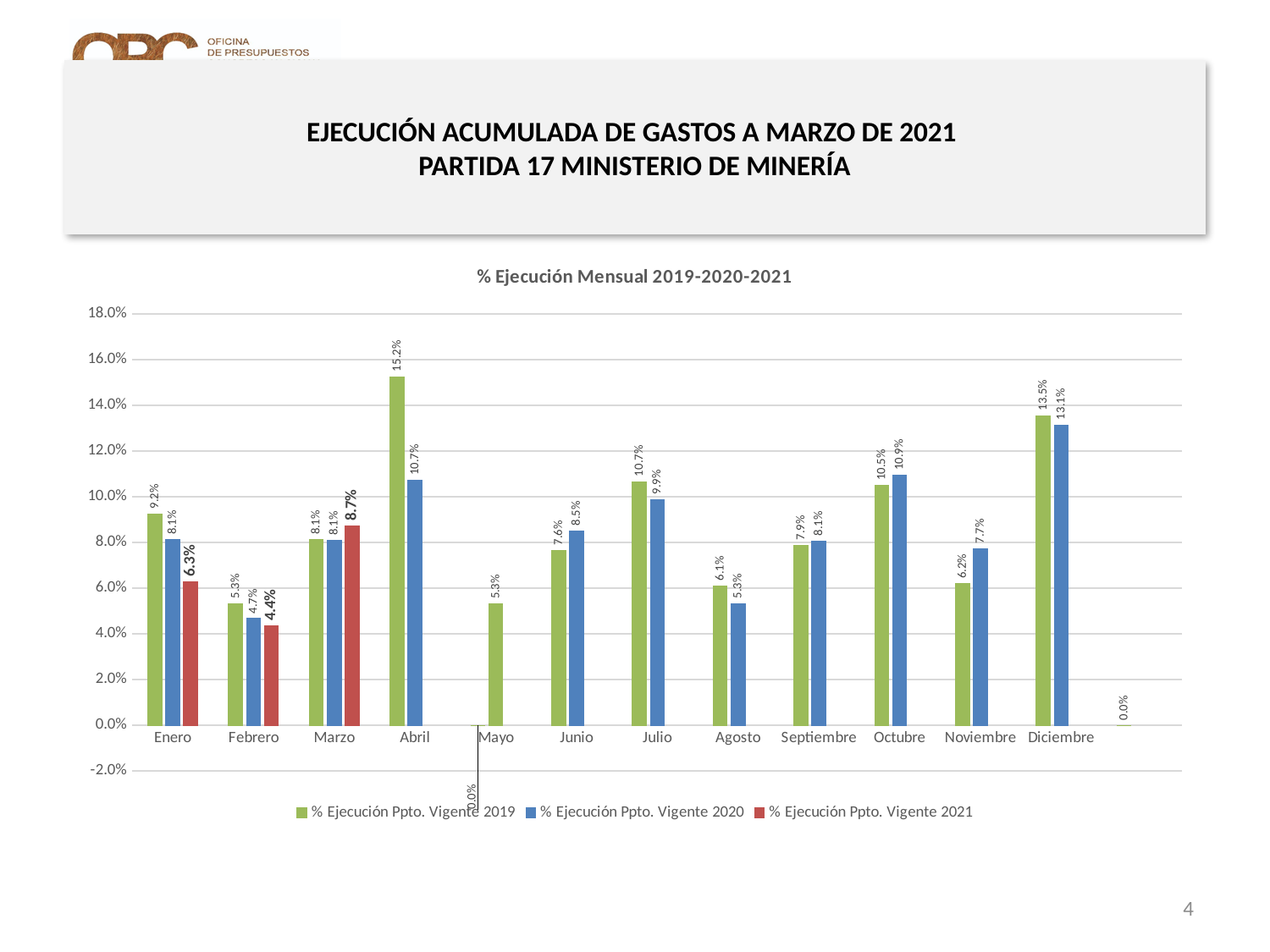
Which month has the highest value in the % Ejecución Ppto. Vigente 2019 series? Abril For Octubre, which series has the larger value, 2019 or 2020? 2020 What is the value for Noviembre in the % Ejecución Ppto. Vigente 2020 series? 7.7% What is the value for Marzo in the % Ejecución Ppto. Vigente 2021 series? 8.7% What is the value for Abril in the % Ejecución Ppto. Vigente 2019 series? 15.2% How many series does the legend list? 3 What is the difference between the 2019 and 2020 values for Abril? 4.5% What type of chart is shown on the slide? Bar chart Which month has the lowest value in the % Ejecución Ppto. Vigente 2021 series? Febrero For Julio, which series has the larger value, 2019 or 2020? 2019 How many months are shown on the x axis? 12 What is the difference between the 2019 and 2021 values for Enero? 2.9%